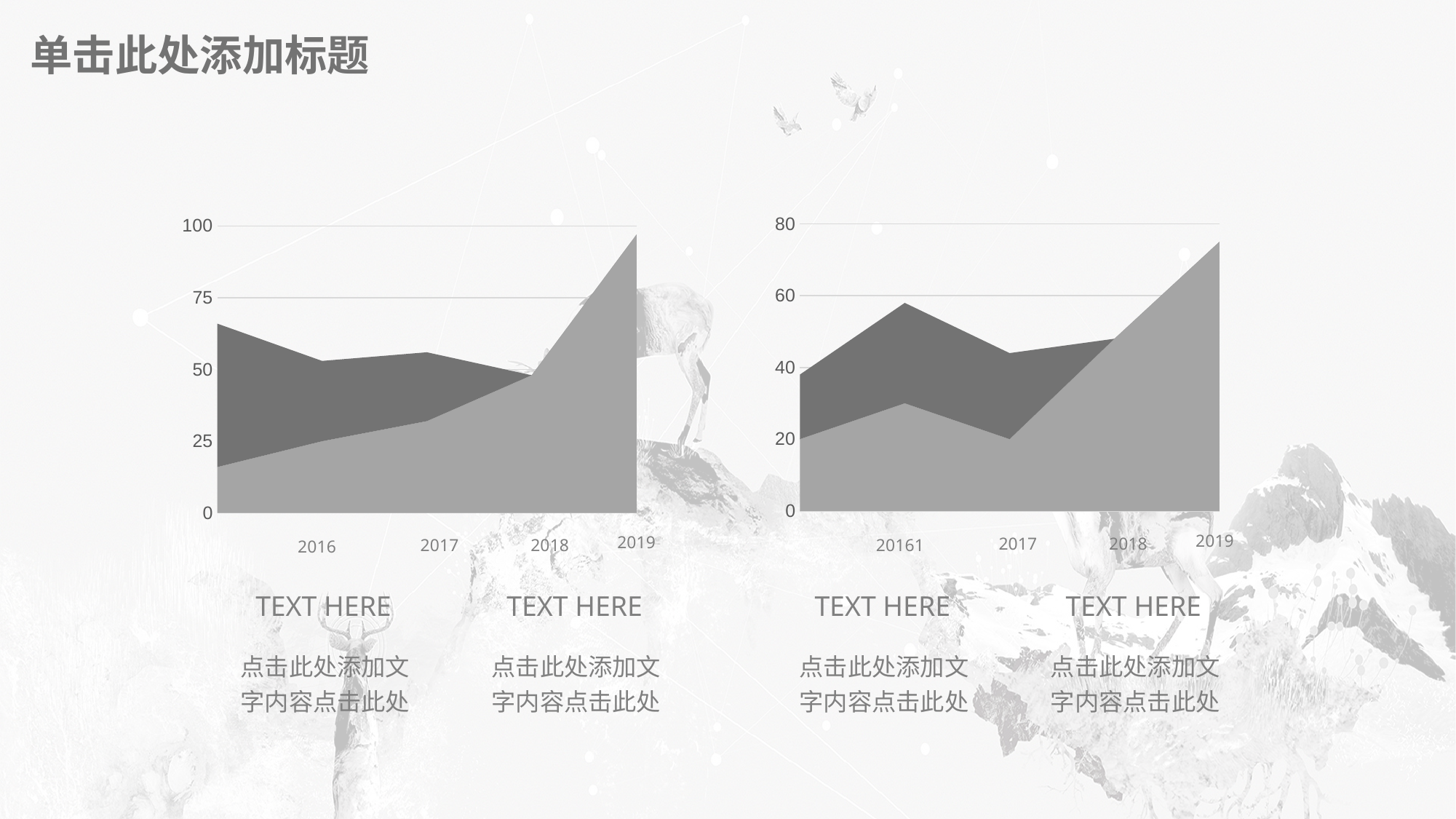
In the right chart, is the value of the lighter series for 2019 greater or less than 60? greater In the left chart, in which year does the lighter series reach its highest value? 2019 What kind of chart is the chart on the left side of the slide? area chart In the left chart, is the value of the lighter series for 2019 greater or less than 75? greater How many shaded series are plotted in the right chart? 2 How many years are shown on the x axis of the left chart? 4 In the left chart, does the lighter series rise or fall from 2016 to 2019? rise